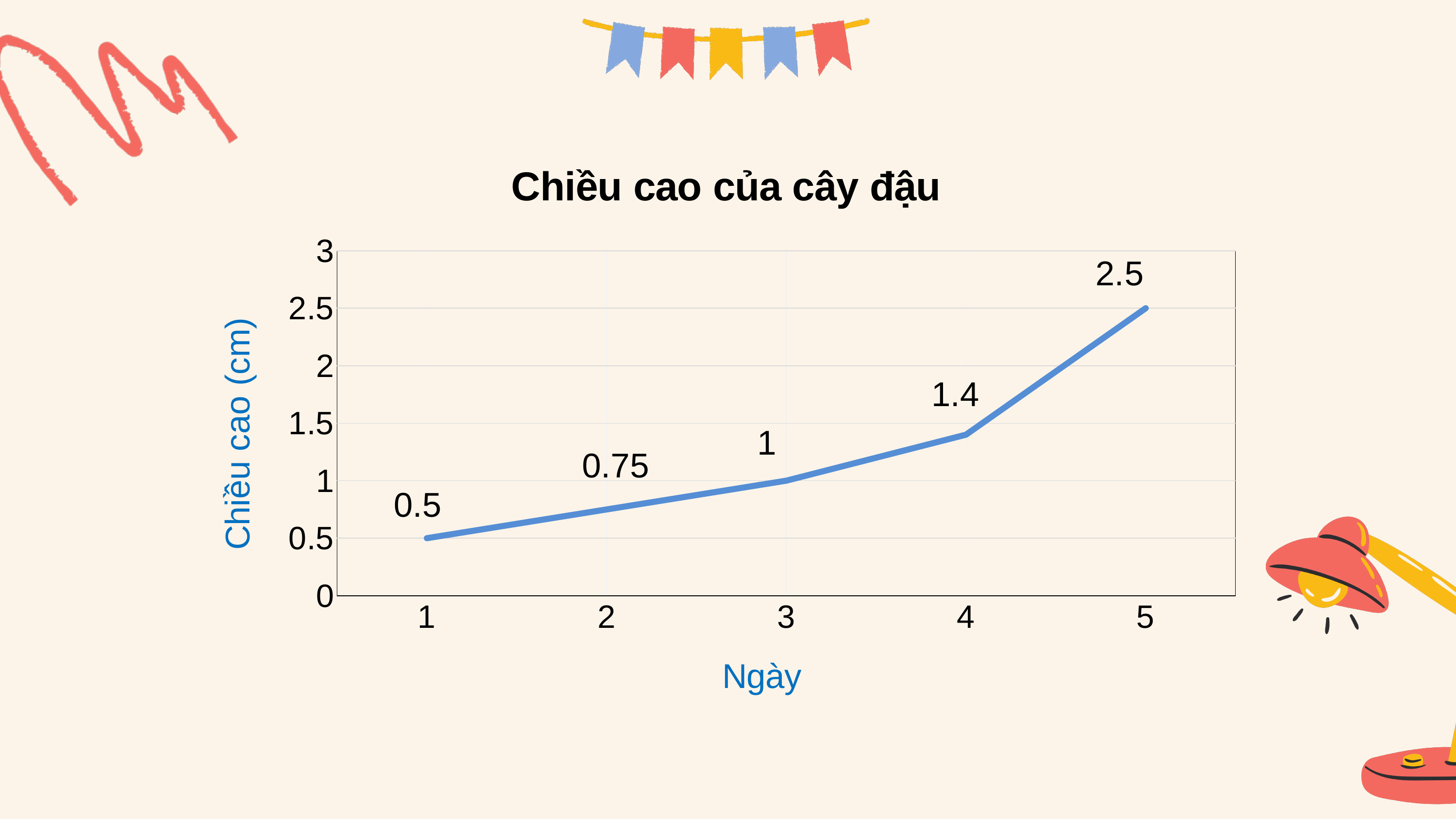
Do the values rise or fall from day 1 to day 5? rise What is the height of the bean plant on day 3? 1 How many data points are plotted on the chart? 5 Is the value for day 4 greater or less than 1.5? less What is the difference in height between day 2 and day 1? 0.25 What is the height of the bean plant on day 1? 0.5 What is the height of the bean plant on day 5? 2.5 Which day has a greater height, day 2 or day 4? 4 What kind of chart is shown on the slide? line chart On which day is the plant height lowest? 1 What is the difference in height between day 5 and day 4? 1.1 On which day is the plant height highest? 5